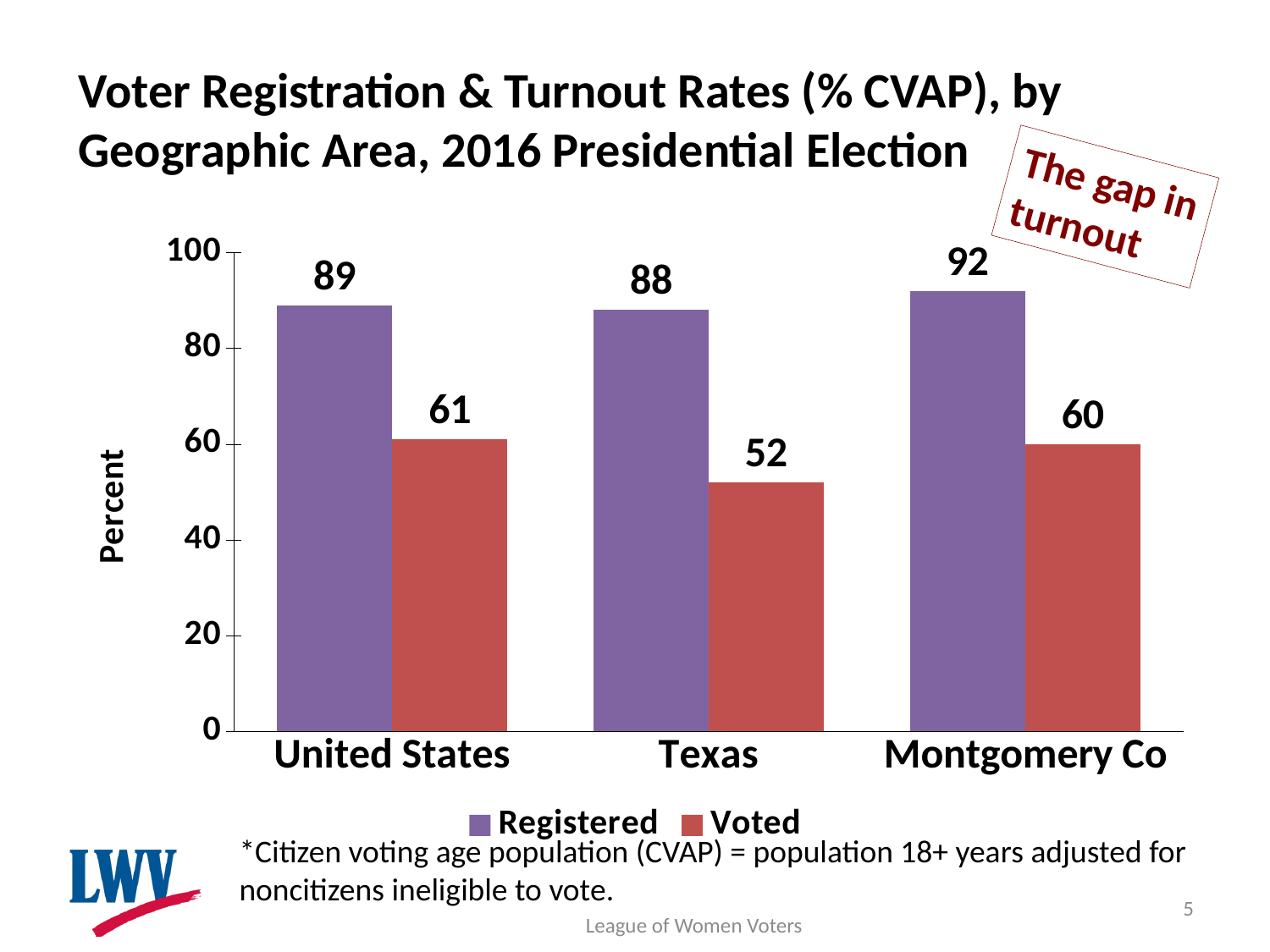
Which geographic area has the highest Registered value? Montgomery Co How many series does the legend list? 2 Which geographic area has the lowest Voted value? Texas What is the Registered value for Texas? 88 What is the Voted value for the United States? 61 What is the label on the vertical axis? Percent What is the Voted value for Montgomery Co? 60 Which is larger, the Voted value for the United States or the Voted value for Montgomery Co? United States How many geographic areas are shown on the x axis? 3 What is the difference between the Voted values for the United States and Texas? 9 What is the difference between the Registered and Voted values for Texas? 36 What kind of chart is shown on the slide? Bar chart